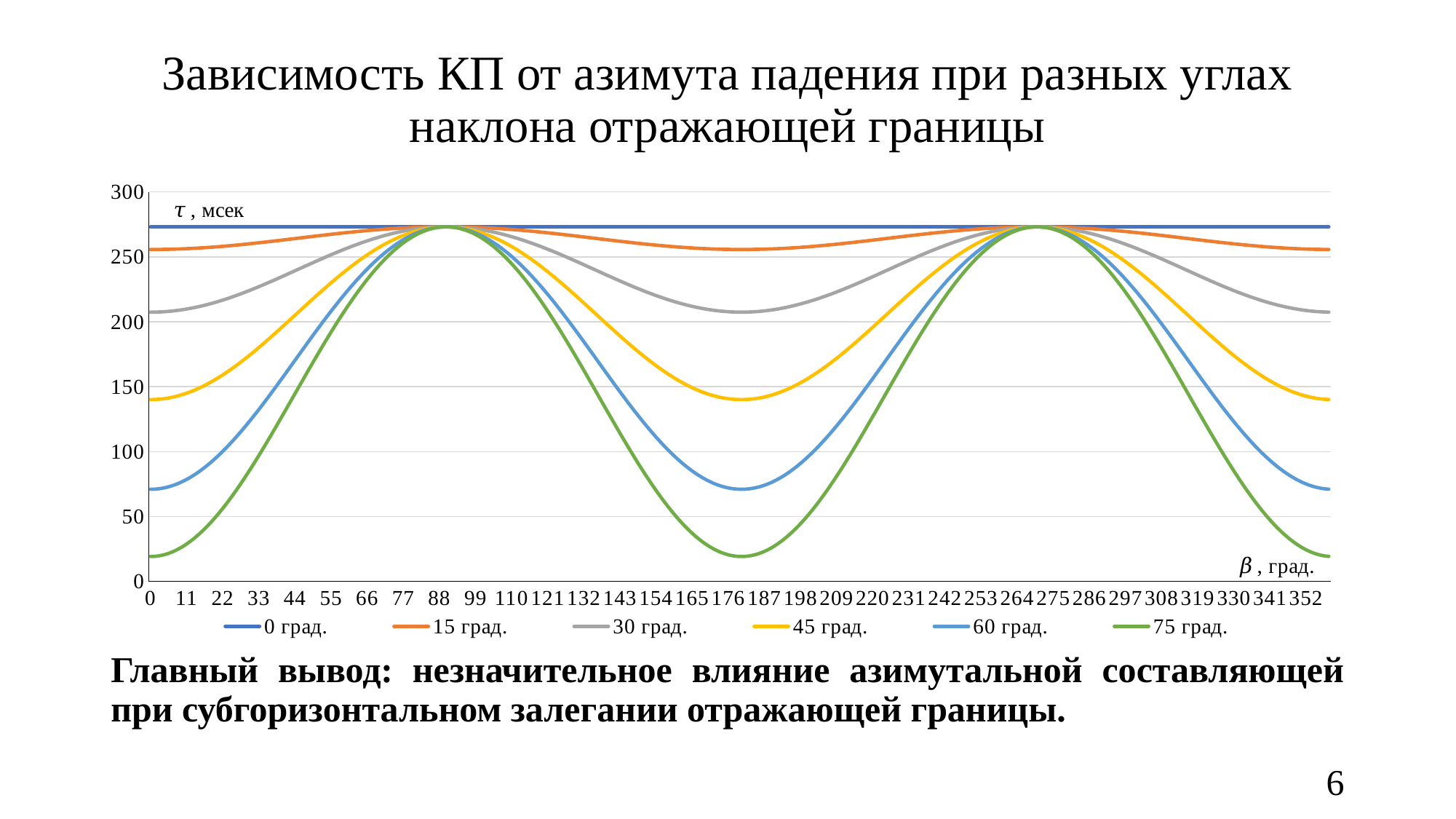
Is the value of the 30 град. series at β = 0 greater or less than 200? greater What unit is shown for the vertical axis label τ? мсек Is the value of the 75 град. series at β = 0 greater or less than 50? less How many series does the legend list? 6 Does the 75 град. series rise or fall as β goes from 0 to 88? rise What kind of chart is shown on the slide? line chart Which series stays constant across all values of β? 0 град. Is the value of the 60 град. series at β = 0 greater or less than 50? greater Which series reaches the lowest value on the chart? 75 град. At β = 176, which series has the larger value: 60 град. or 75 град.? 60 град.